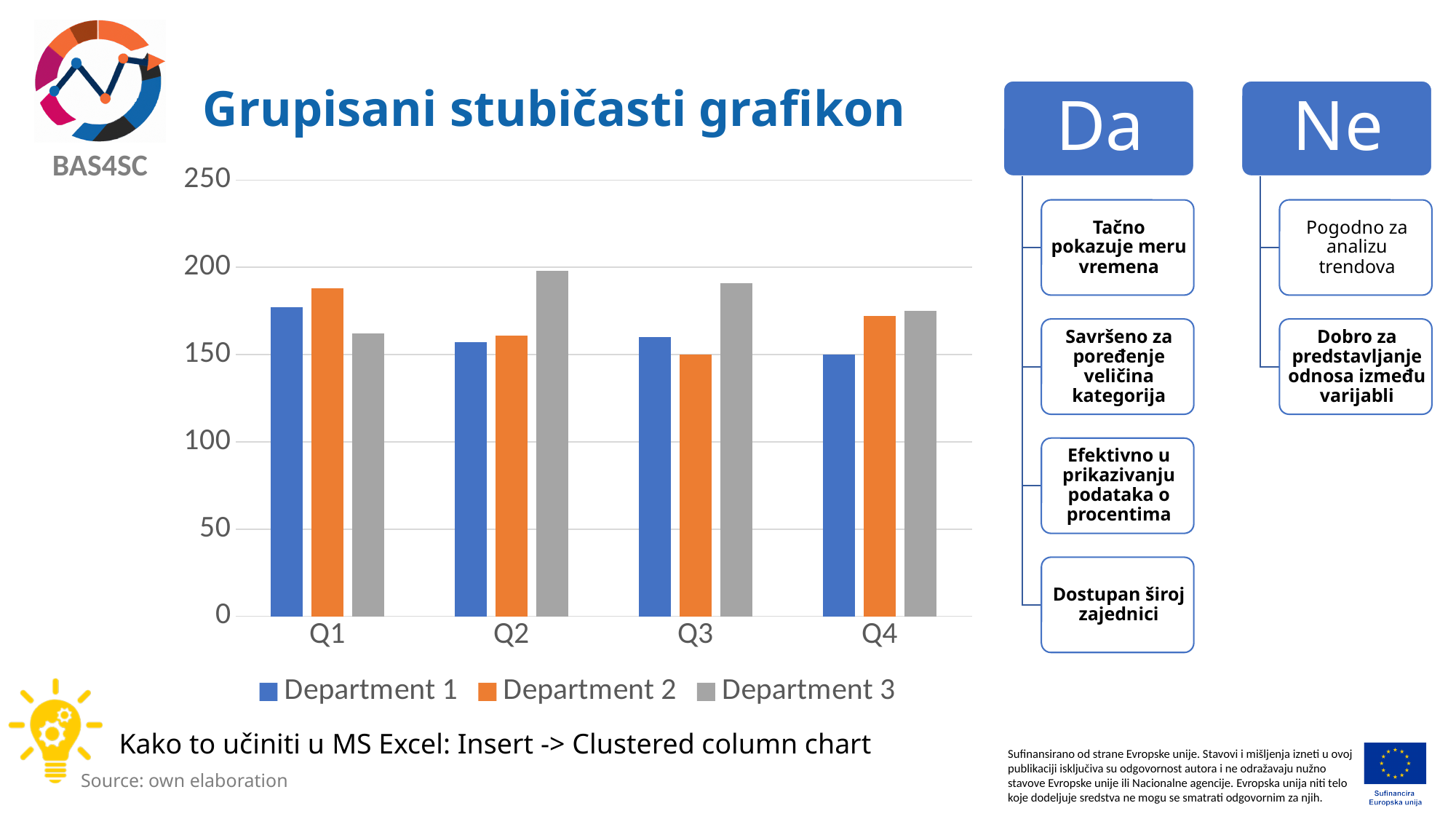
Is the value for Department 3 in Q2 greater or less than 150? greater Which department has the lowest value in Q4? Department 1 What is the title of the chart on the slide? Grupisani stubičasti grafikon Which department has the highest value in Q3? Department 3 How many series does the chart's legend list? 3 What kind of chart is shown on the slide? Bar chart Is the value for Department 2 in Q1 greater or less than 150? greater Which department has the highest value in Q2? Department 3 Is the value for Department 1 in Q1 greater or less than 200? less Which is larger for Department 1: the value in Q1 or the value in Q4? Q1 How many categories are shown on the x axis of the chart? 4 Which colour represents Department 2 in the chart? Orange